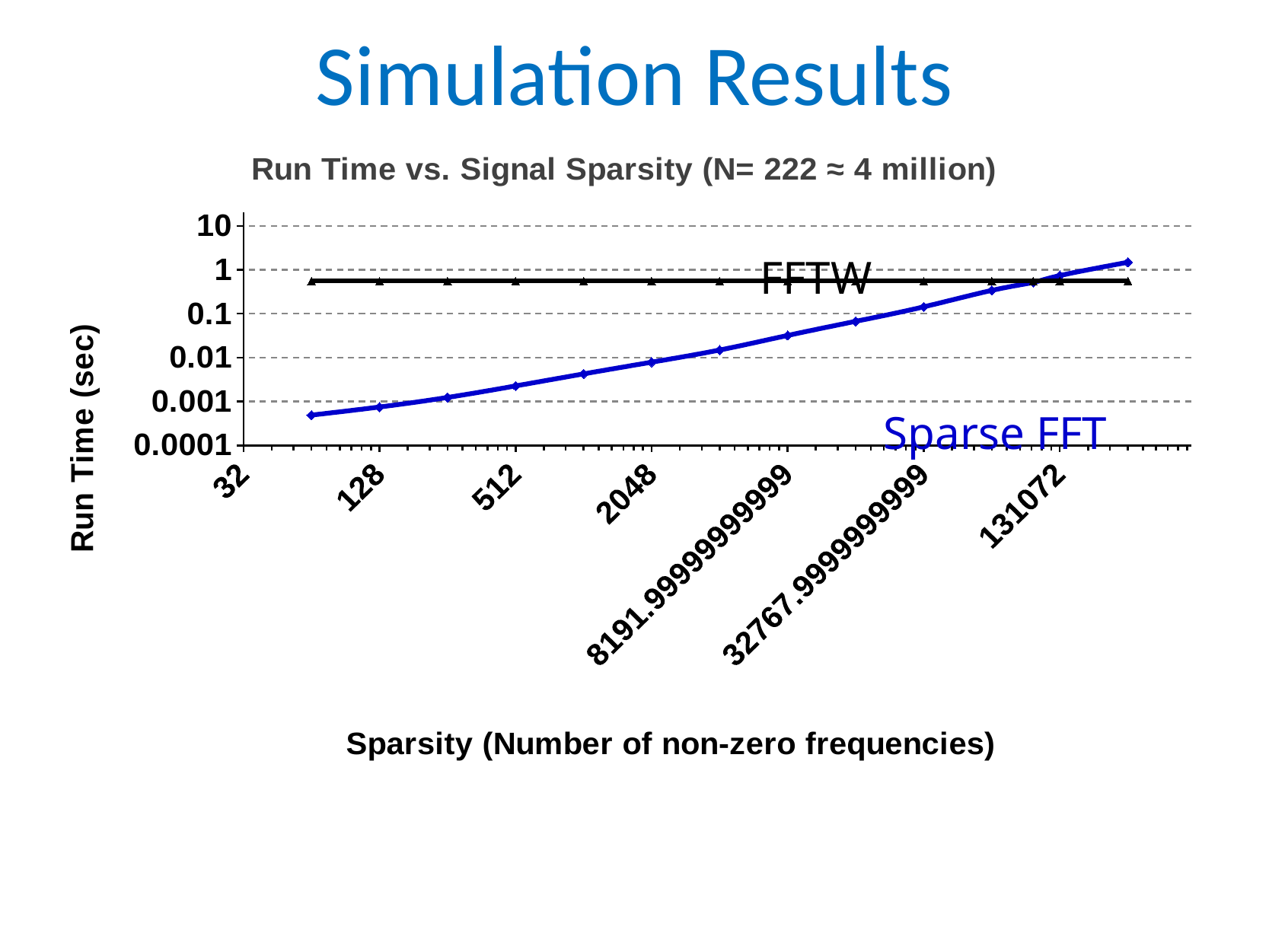
At sparsity 128, which has the larger run time, FFTW or Sparse FFT? FFTW At the rightmost sparsity value, which has the larger run time, FFTW or Sparse FFT? Sparse FFT Does the Sparse FFT run time rise or fall as sparsity increases along the x axis? rise Is the Sparse FFT run time at sparsity 512 greater or less than 0.01 seconds? less What kind of chart is shown on the slide? line chart What is the label of the y axis? Run Time (sec) How many series are plotted on the chart? 2 Is the run time of FFTW greater or less than 0.1 seconds? greater Is the run time of FFTW greater or less than 1 second? less What is the title of the chart? Run Time vs. Signal Sparsity (N= 222 ≈ 4 million)